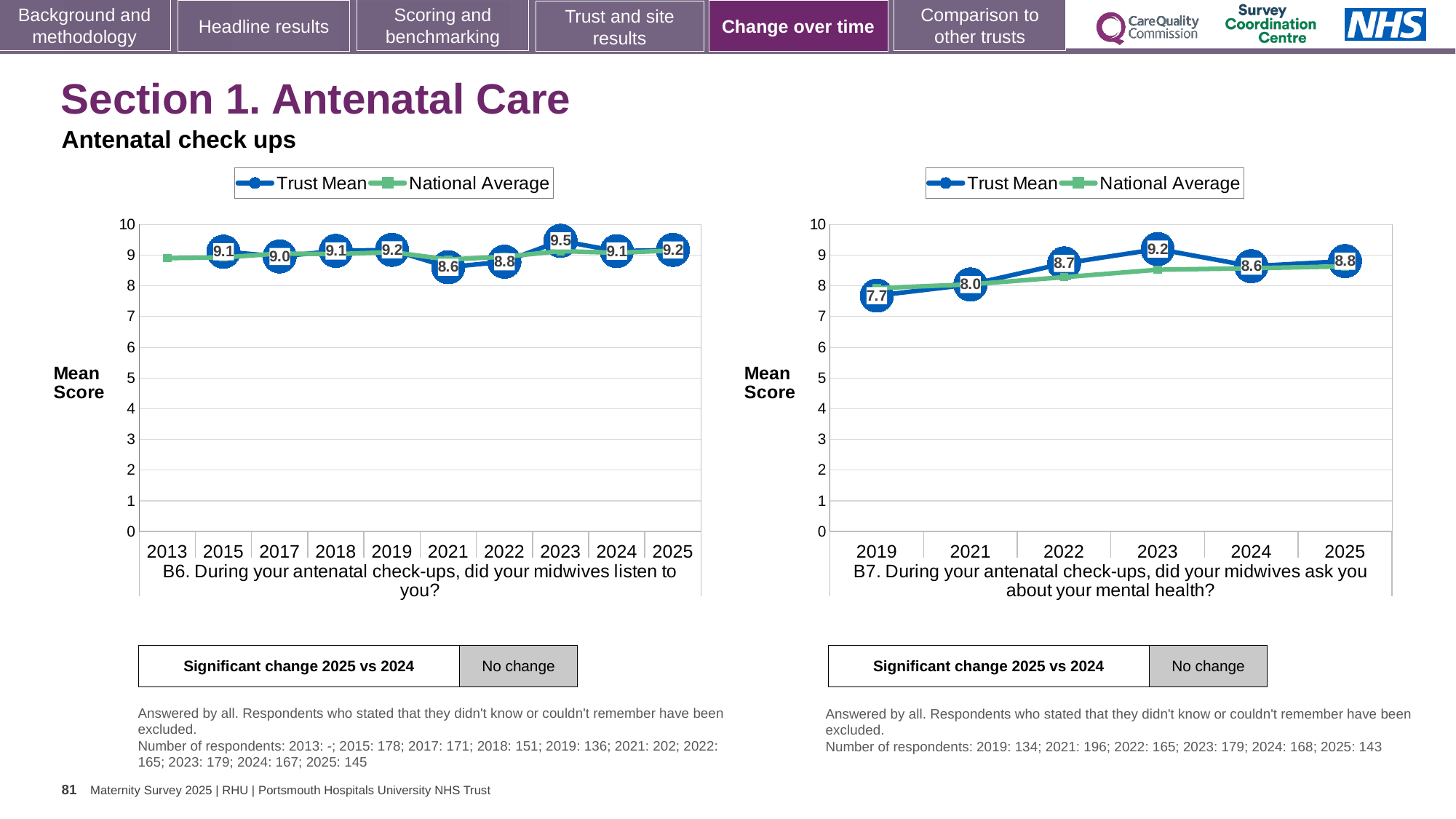
What kind of chart is the B7 chart (right)? Line chart How many series does the legend of the B6 chart (left) list? 2 How many years are shown on the x axis of the B7 chart (right)? 6 In the B6 chart (left), which year has the highest Trust Mean? 2023 In the B7 chart (right), which year has the lowest Trust Mean? 2019 In the B7 chart (right), what is the difference between the Trust Mean for 2023 and the Trust Mean for 2019? 1.5 In the B7 chart (right), is the National Average for 2019 greater or less than 7? greater In the B7 chart (right), what is the Trust Mean for 2025? 8.8 In the B6 chart (left), what is the Trust Mean for 2023? 9.5 In the B6 chart (left), which is larger: the Trust Mean for 2022 or the Trust Mean for 2024? 2024 In the B7 chart (right), what is the Trust Mean for 2019? 7.7 In the B6 chart (left), what is the Trust Mean for 2021? 8.6